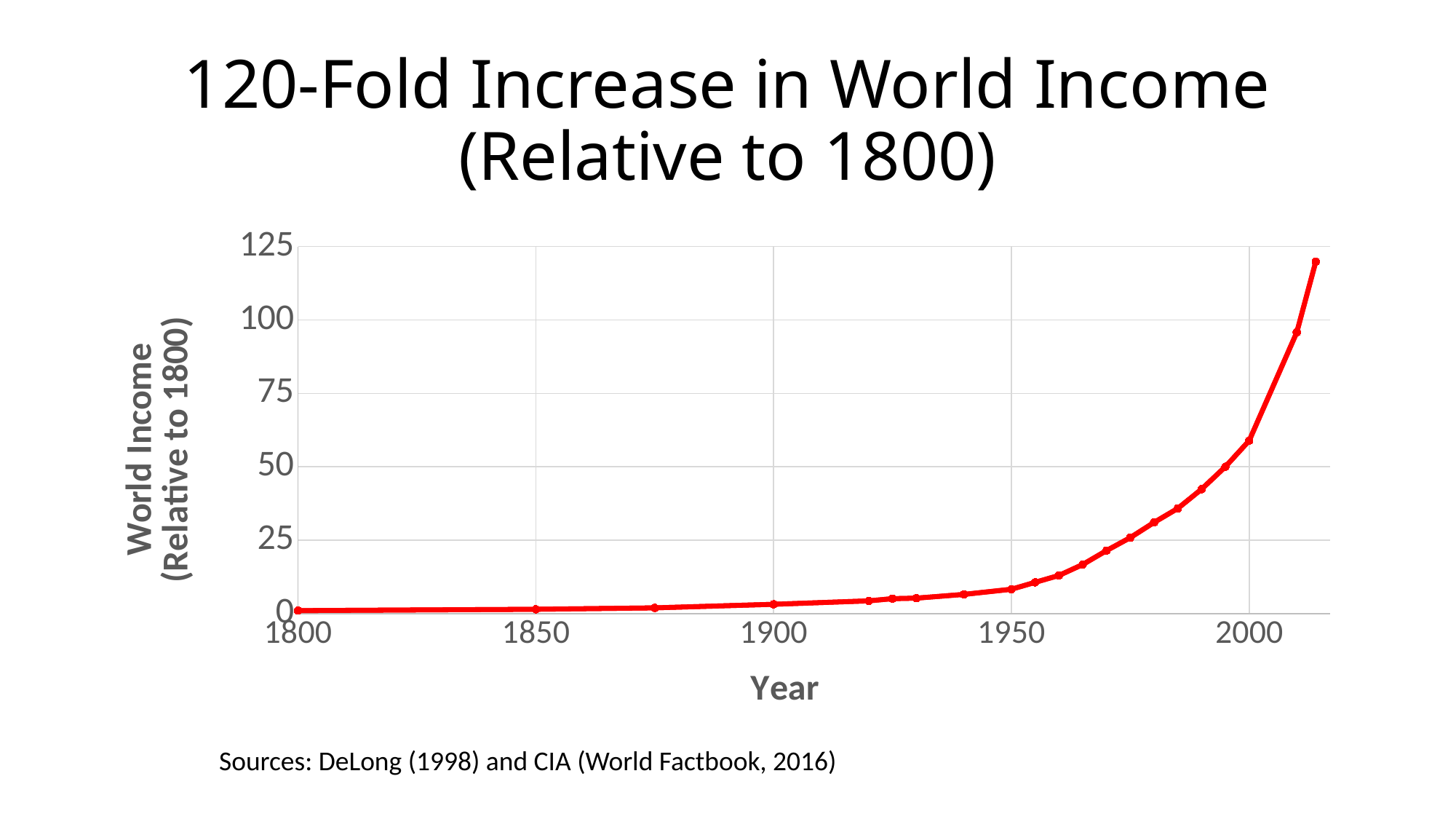
Is the value for the year 1950 greater or less than 25? less What is the title of the chart? 120-Fold Increase in World Income (Relative to 1800) Is the value for the year 1900 greater or less than 25? less Is the value for the year 2010 greater or less than 75? greater What is the label of the vertical axis? World Income (Relative to 1800) What kind of chart is shown on the slide? line chart Is the highest value on the line at the beginning or the end of the period shown? end Do the values rise or fall as the year increases along the x axis? rise Which year has the larger value, 1950 or 2000? 2000